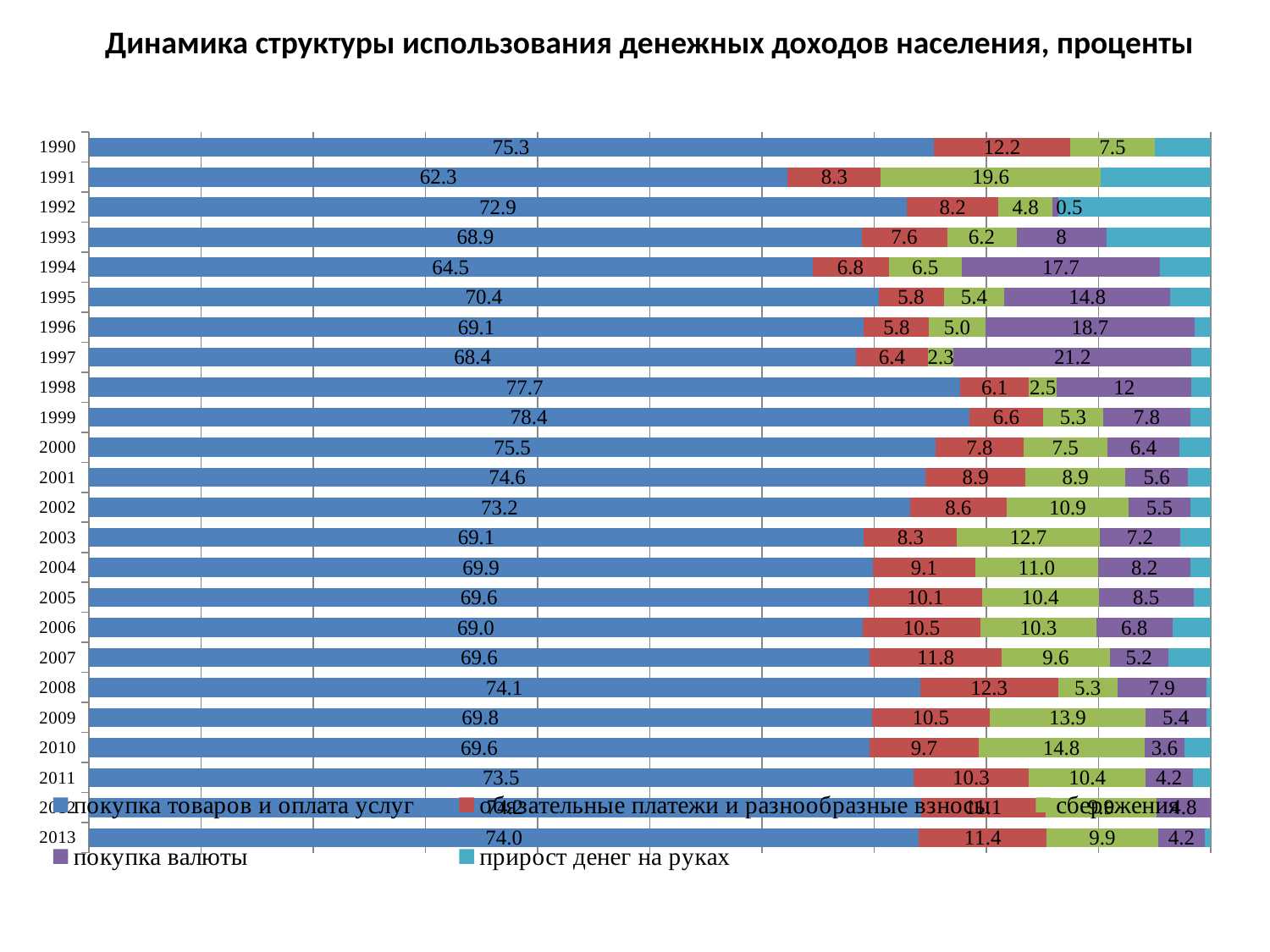
In which year is the value of 'покупка товаров и оплата услуг' the lowest? 1991 What is the value of 'покупка товаров и оплата услуг' for 1999? 78.4 In which year is the value of 'покупка товаров и оплата услуг' the highest? 1999 What is the value of 'сбережения' for 1991? 19.6 What kind of chart is shown on the slide? Stacked bar chart What is the title of the chart? Динамика структуры использования денежных доходов населения, проценты What is the value of 'обязательные платежи и разнообразные взносы' for 2008? 12.3 In which year is the value of 'покупка валюты' the highest? 1997 How many series does the legend list? 5 Which year has the larger 'сбережения' value, 2009 or 2010? 2010 What is the value of 'покупка валюты' for 1997? 21.2 What is the difference between the 'покупка товаров и оплата услуг' values for 1999 and 1991? 16.1